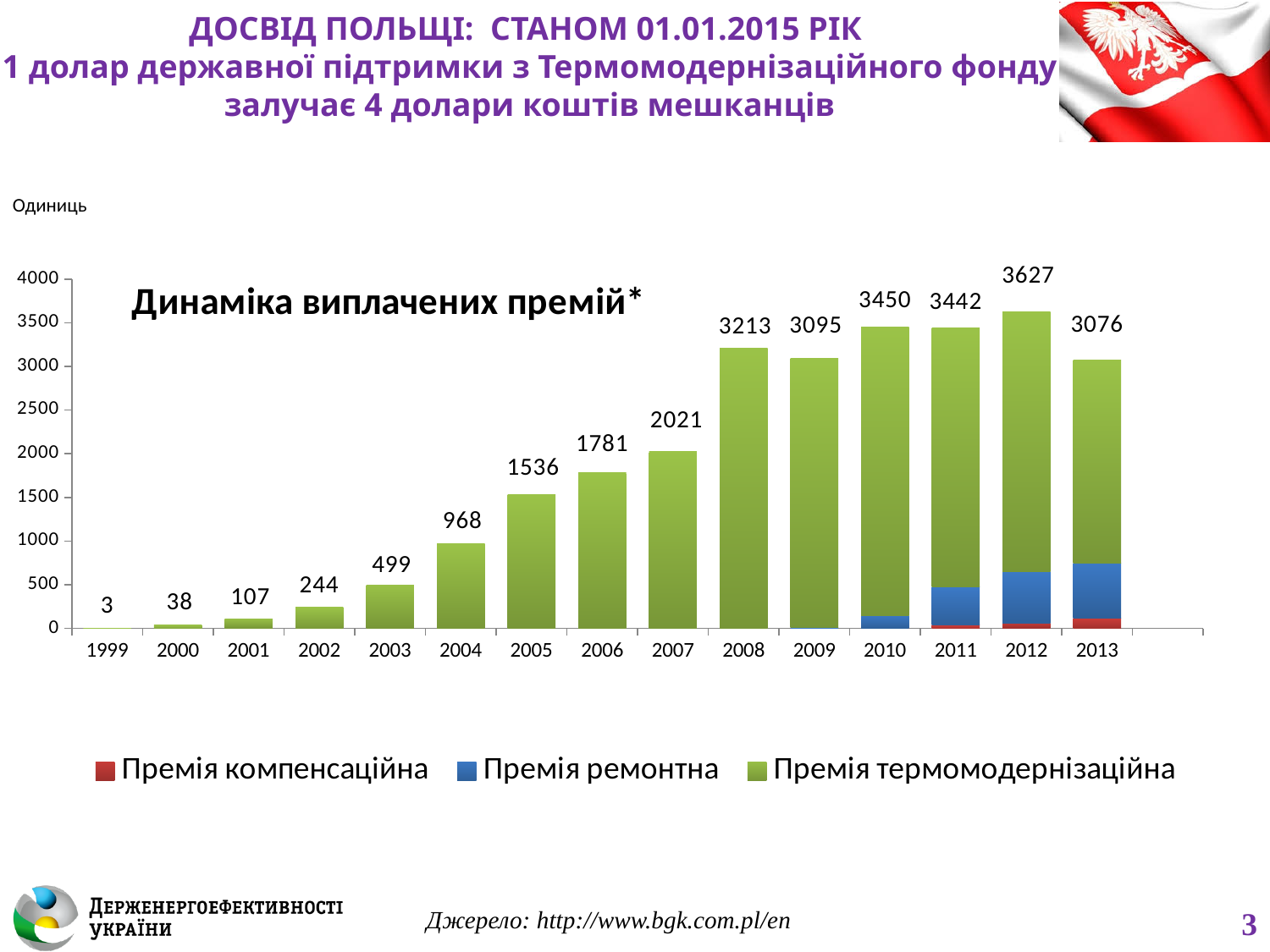
What kind of chart is shown? stacked bar chart Is the 'Премія ремонтна' segment for 2013 greater or less than 1000? less How many series does the legend list? 3 Which year has the larger total, 2008 or 2009? 2008 What is the total value shown for 2005? 1536 Do the totals rise or fall from 1999 to 2008? rise What is the total value shown for 2012? 3627 What is the total value shown for 1999? 3 Which year has the lowest total? 1999 What is the difference between the totals for 2012 and 2013? 551 How many years are shown on the x axis? 15 Which year has the highest total? 2012